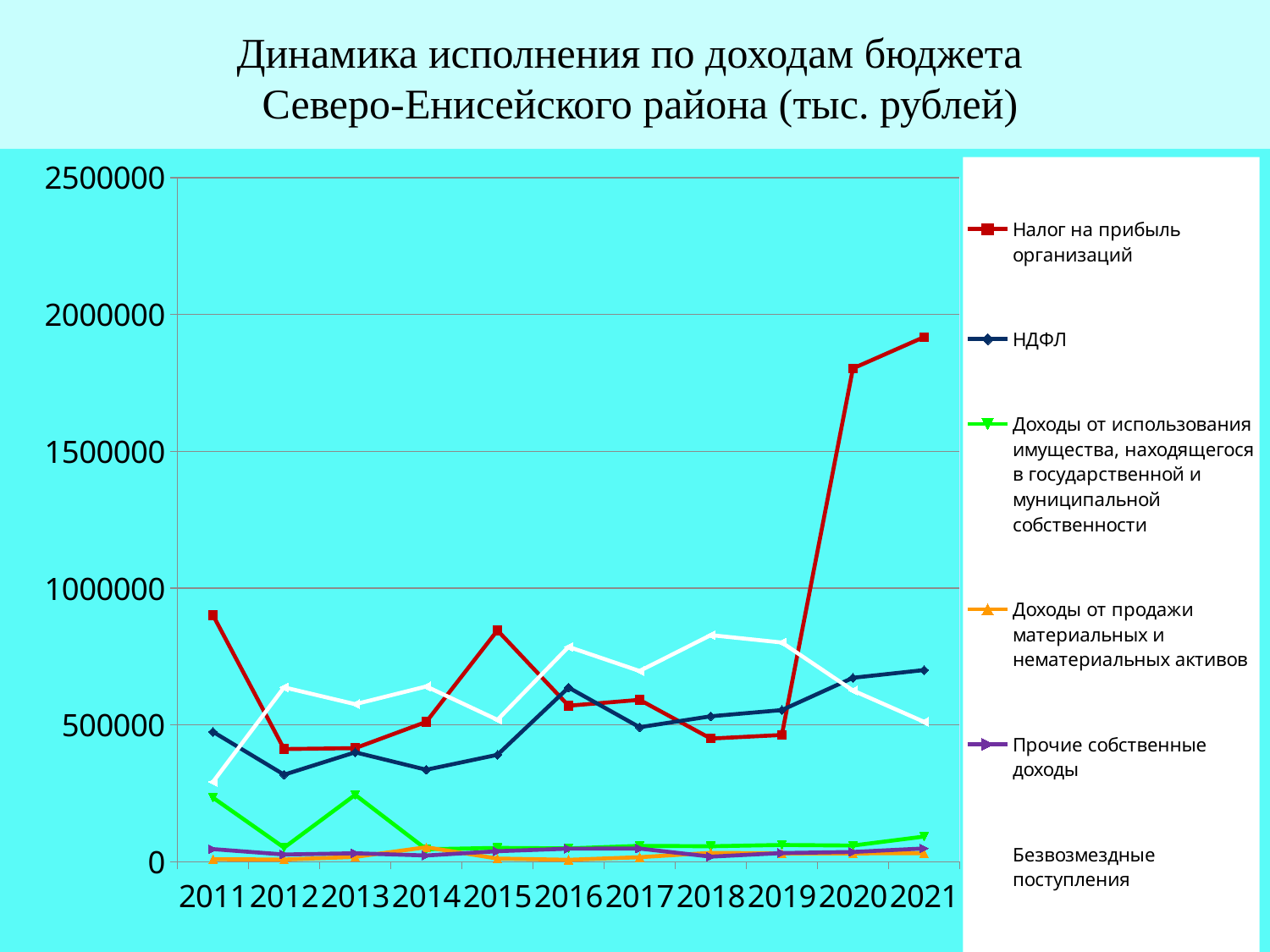
In 2018, which is larger: Безвозмездные поступления or Налог на прибыль организаций? Безвозмездные поступления Is the value for Налог на прибыль организаций in 2011 greater or less than 1000000? less Which series has the highest value in 2021? Налог на прибыль организаций Is the value for Налог на прибыль организаций in 2021 greater or less than 1500000? greater Which is larger for Налог на прибыль организаций: the value in 2011 or the value in 2012? 2011 How many years are shown along the x axis? 11 Does the value for Налог на прибыль организаций rise or fall from 2019 to 2021? rise In which year is the value for Налог на прибыль организаций highest? 2021 How many series does the legend list? 6 What kind of chart is shown on the slide? line chart Is the value for Безвозмездные поступления in 2018 greater or less than 500000? greater